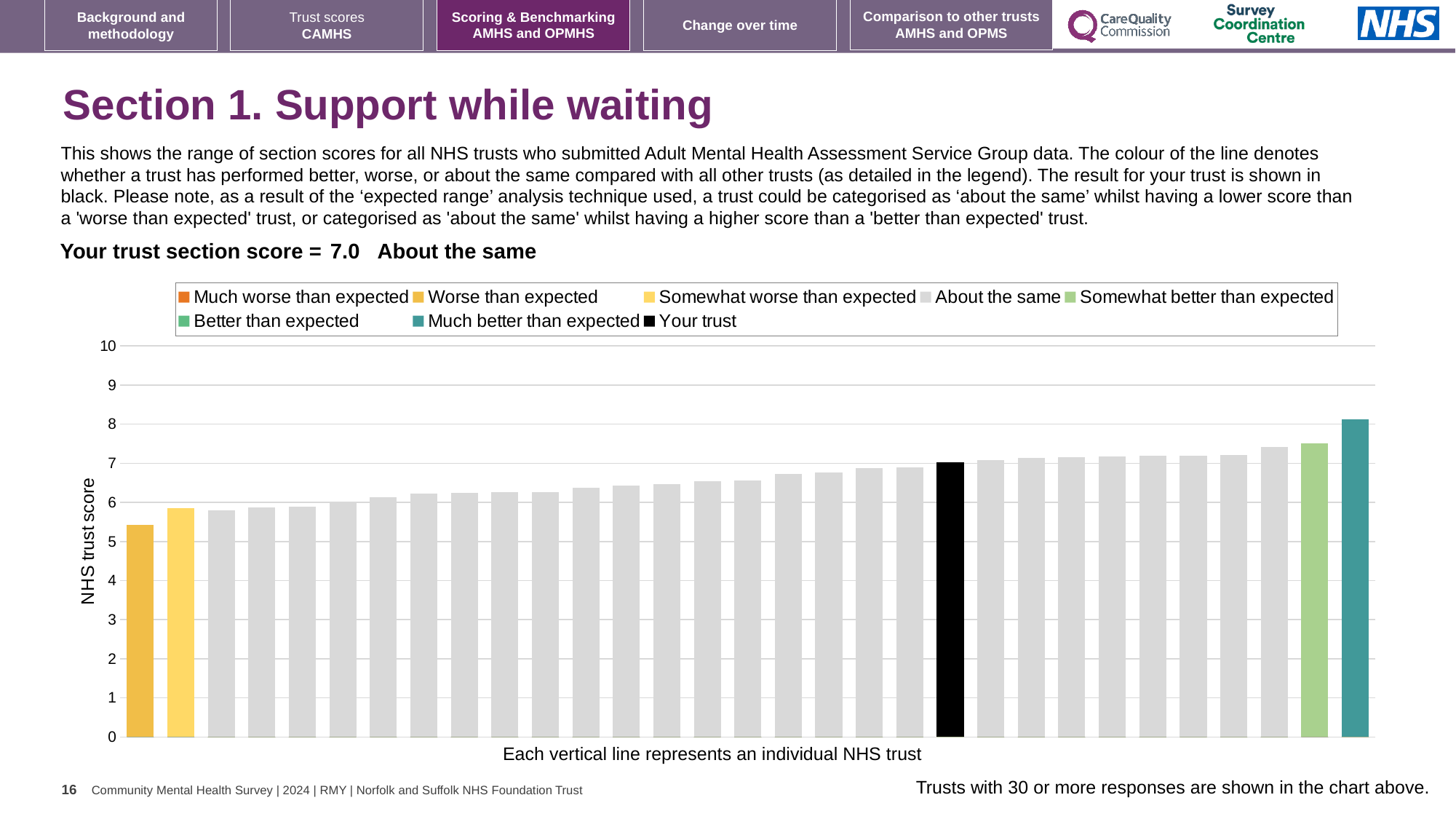
Do the bar values rise or fall from left to right across the chart? rise Is the value of the black 'Your trust' bar greater or less than 6? greater Which is larger: the black 'Your trust' bar or the teal rightmost bar? the teal rightmost bar What is the label on the vertical axis of the chart? NHS trust score Which legend category does the tallest bar belong to? Much better than expected Which category is your trust placed in for this section? About the same Is the value of the light green 'Somewhat better than expected' bar greater or less than 7? greater Is the value of the leftmost (lowest) bar greater or less than 6? less What kind of chart is shown on the slide? bar chart What is the section score for your trust shown on the slide? 7.0 How many entries does the chart legend list? 8